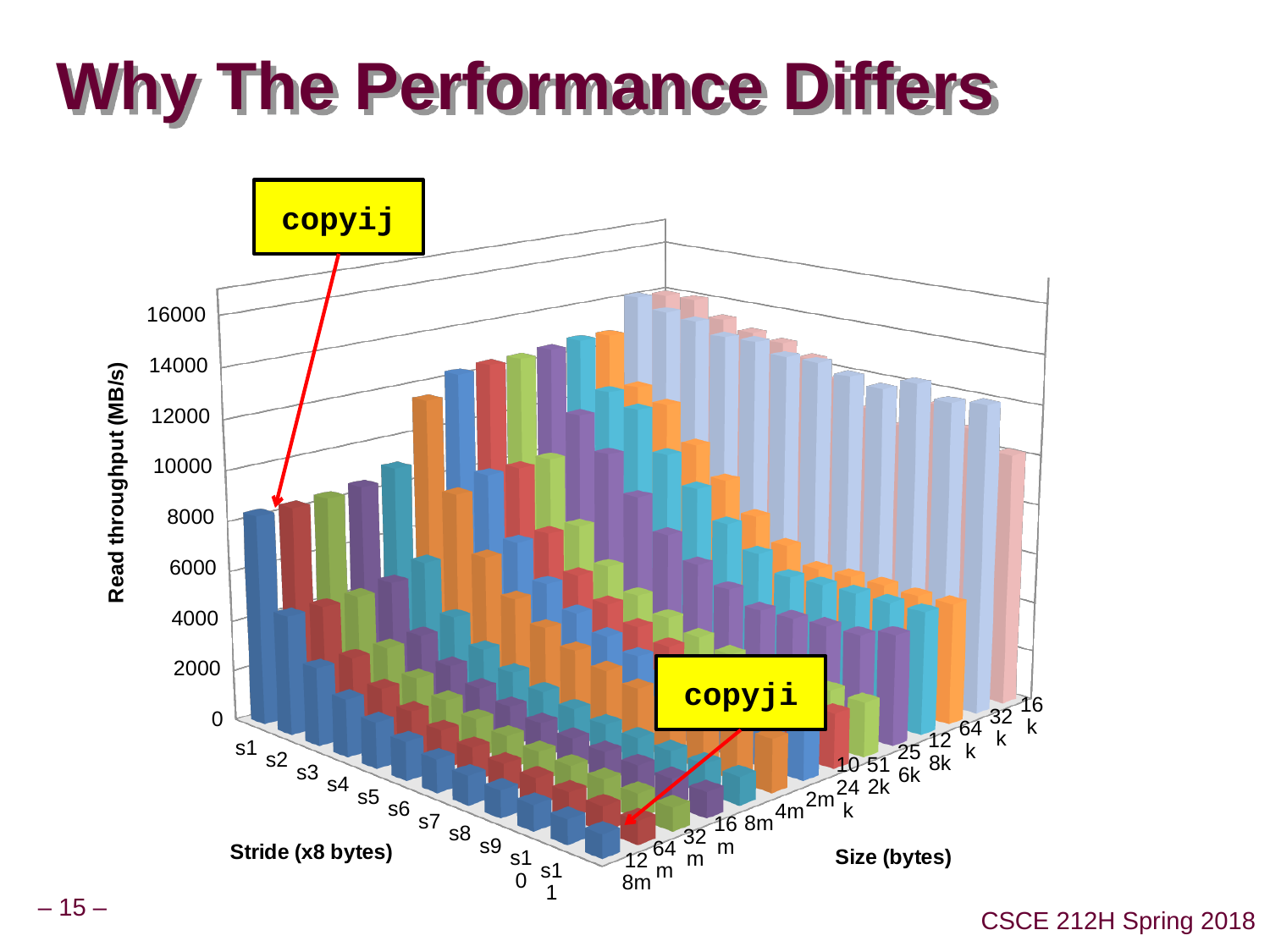
Is the read throughput for stride s1 at size 16k greater or less than 10000? greater How many size categories are shown along the Size (bytes) axis? 14 Is the read throughput for stride s11 at size 128m greater or less than 4000? less What kind of chart is shown on the slide? 3D bar chart For size 128m, does read throughput rise or fall as stride increases from s1 to s11? fall What is the title of the vertical axis? Read throughput (MB/s) At stride s1, which size has the higher read throughput, 16k or 128m? 16k Which label is attached by an arrow to the front-most bar (stride s11, size 128m)? copyji How many stride categories are shown along the Stride (x8 bytes) axis? 11 At size 128m, which stride has the higher read throughput, s1 or s11? s1